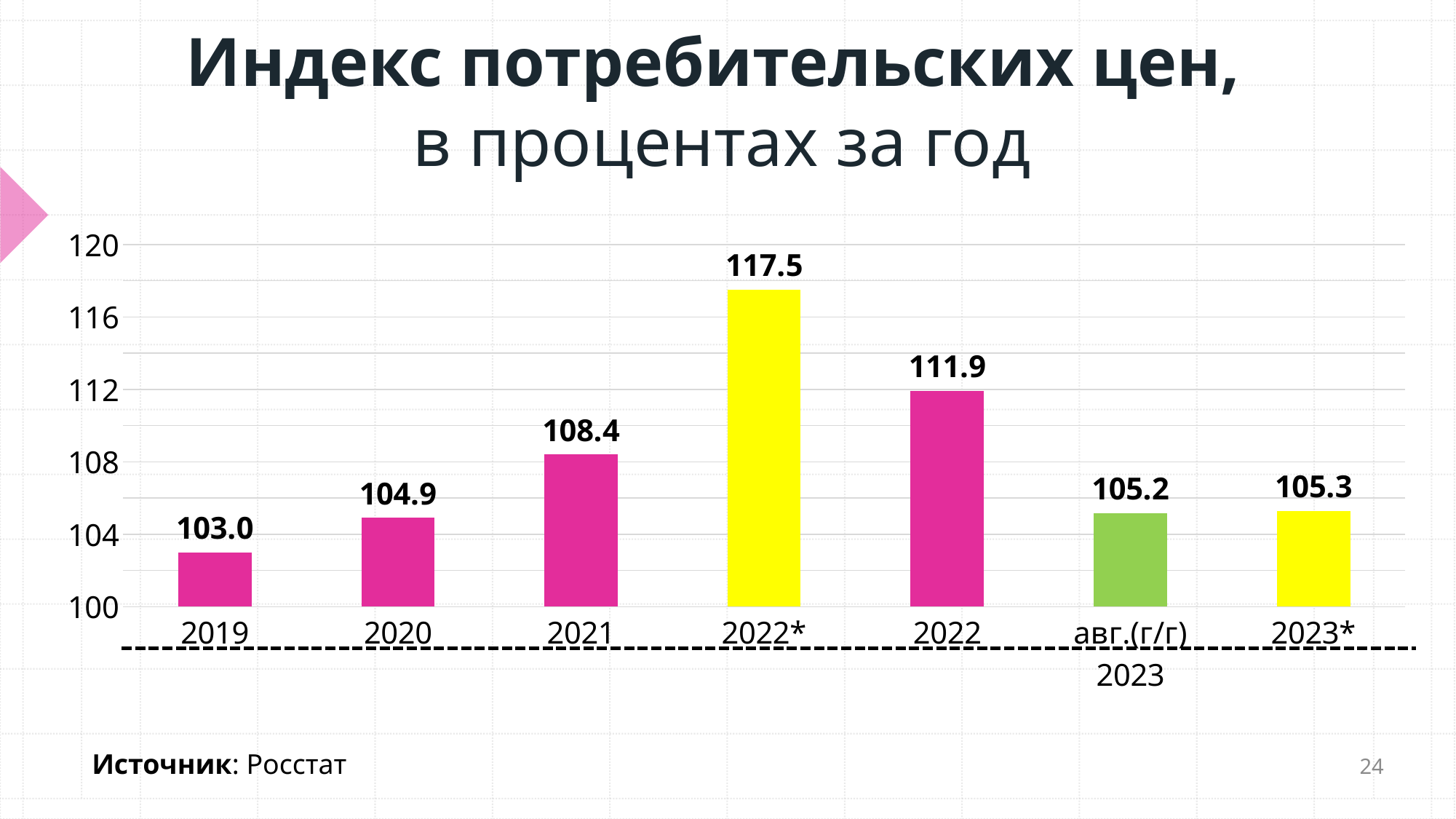
What is the consumer price index value for 2019? 103.0 What is the value shown for авг.(г/г) 2023? 105.2 What is the value shown for 2023*? 105.3 What kind of chart is shown on the slide? bar chart How many bars are shown in the chart? 7 Which is larger, the value for 2021 or the value for 2022? 2022 What is the difference between the values for 2022* and 2022? 5.6 Which category has the highest value? 2022* What is the source cited for the chart? Росстат What is the value shown for 2022*? 117.5 Which category has the lowest value? 2019 What is the difference between the values for 2021 and 2020? 3.5